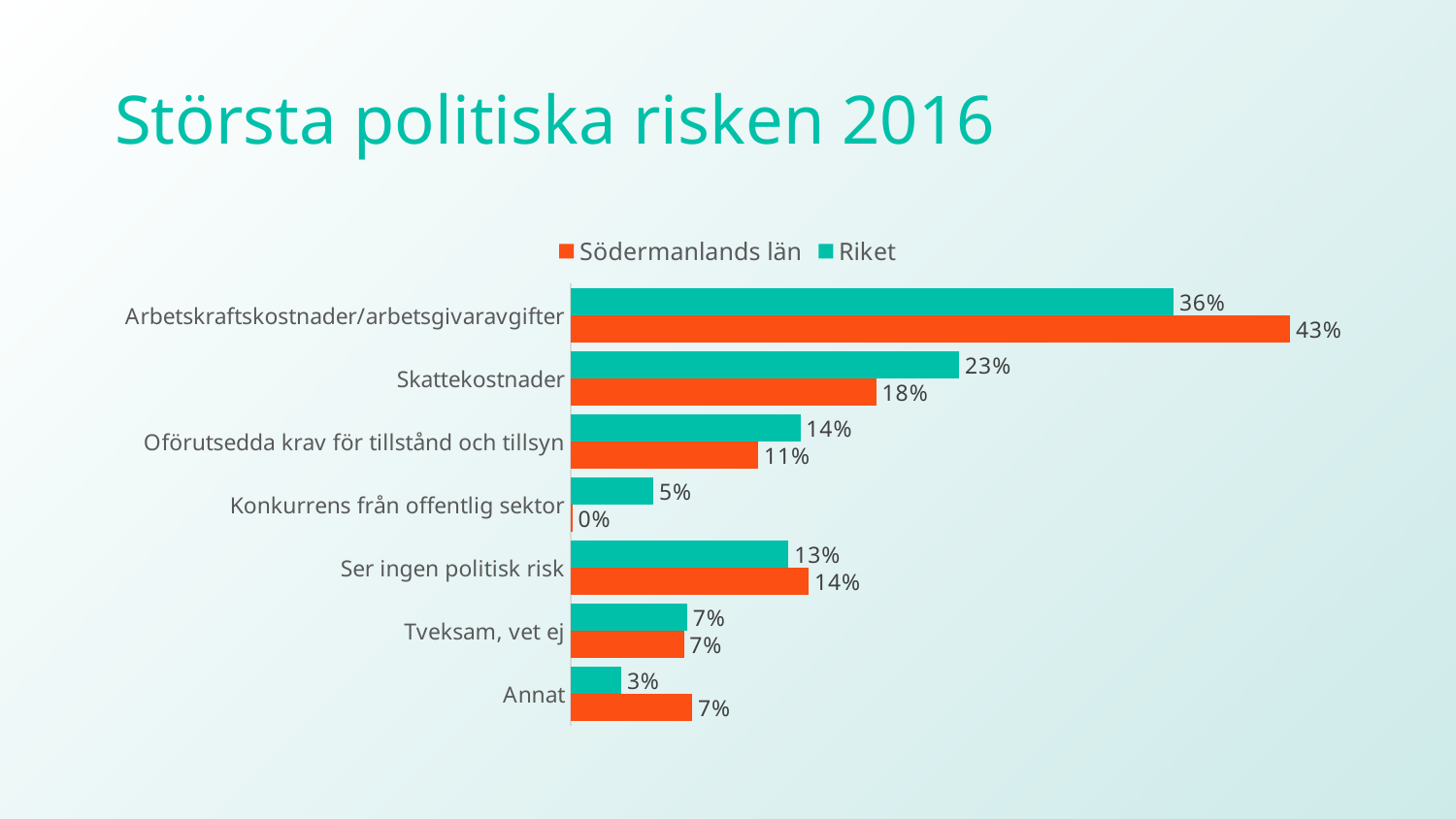
How many series does the legend list? 2 Which category has the highest value for Riket? Arbetskraftskostnader/arbetsgivaravgifter What is the difference between Södermanlands län and Riket for Arbetskraftskostnader/arbetsgivaravgifter? 7% What is the value for Riket for Skattekostnader? 23% Which is larger for Annat: Södermanlands län or Riket? Södermanlands län Which is larger for Skattekostnader: Södermanlands län or Riket? Riket What is the value for Södermanlands län for Konkurrens från offentlig sektor? 0% What is the value for Södermanlands län for Arbetskraftskostnader/arbetsgivaravgifter? 43% What is the title of the slide? Största politiska risken 2016 How many categories are shown in the chart? 7 What kind of chart is shown on the slide? Bar chart Which category has the lowest value for Riket? Annat